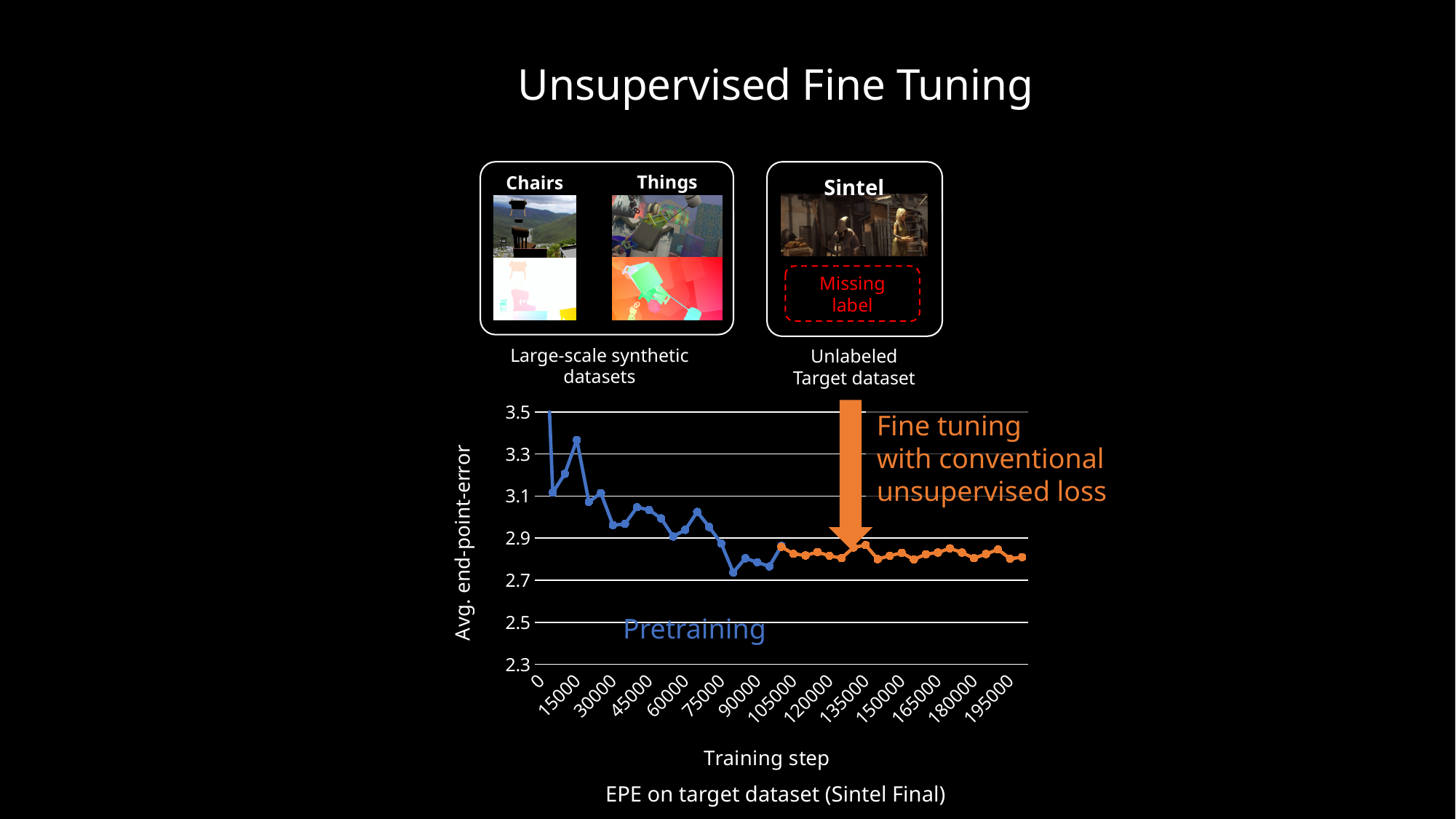
What is the label of the y axis of the chart? Avg. end-point-error Is the value at training step 75000 greater or less than 2.9? less At which training step is the average end-point-error highest? 0 Which is larger, the value at training step 0 or the value at training step 195000? Training step 0 Is the value at training step 0 greater or less than 3.3? greater Is the value at training step 15000 greater or less than 3.3? greater Does the average end-point-error during the Pretraining phase generally rise or fall as the training step increases? Fall Which phase of the curve is drawn in orange? Fine tuning with conventional unsupervised loss What kind of chart is shown on the slide? Line chart What is the label of the x axis of the chart? Training step